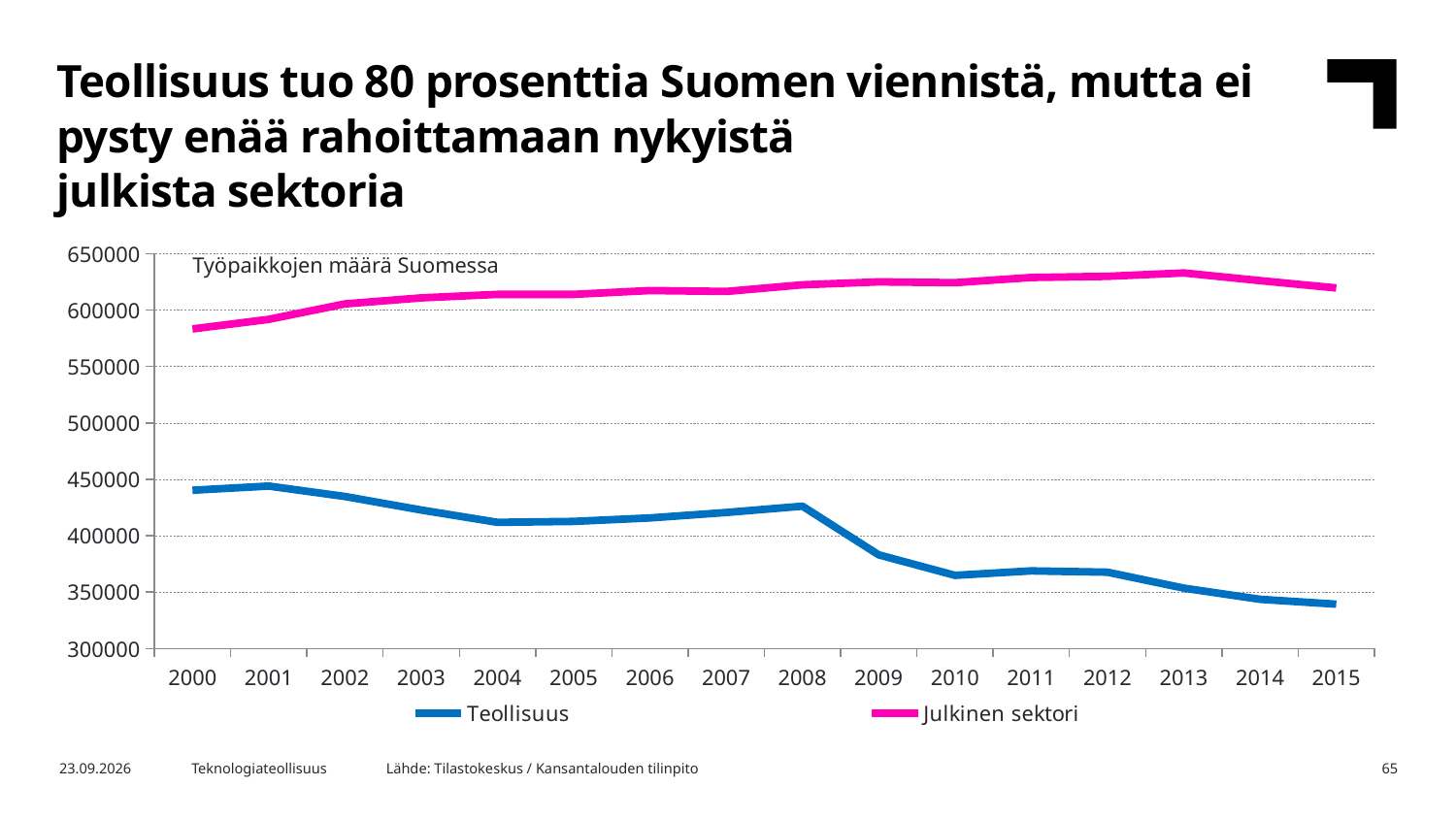
How many series does the legend list? 2 In which year is the Julkinen sektori line at its highest? 2013 In which year is the Julkinen sektori line at its lowest? 2000 How many years are plotted along the x axis? 16 Does the Teollisuus line generally rise or fall from 2000 to 2015? fall What kind of chart is shown on the slide? line chart In which year is the Teollisuus line at its lowest? 2015 Which series is drawn in pink? Julkinen sektori Is the value for Julkinen sektori in 2000 greater or less than 600000? less Is the value for Teollisuus in 2009 greater or less than 400000? less Which series has the higher value in 2010, Teollisuus or Julkinen sektori? Julkinen sektori What is the title shown inside the chart area? Työpaikkojen määrä Suomessa